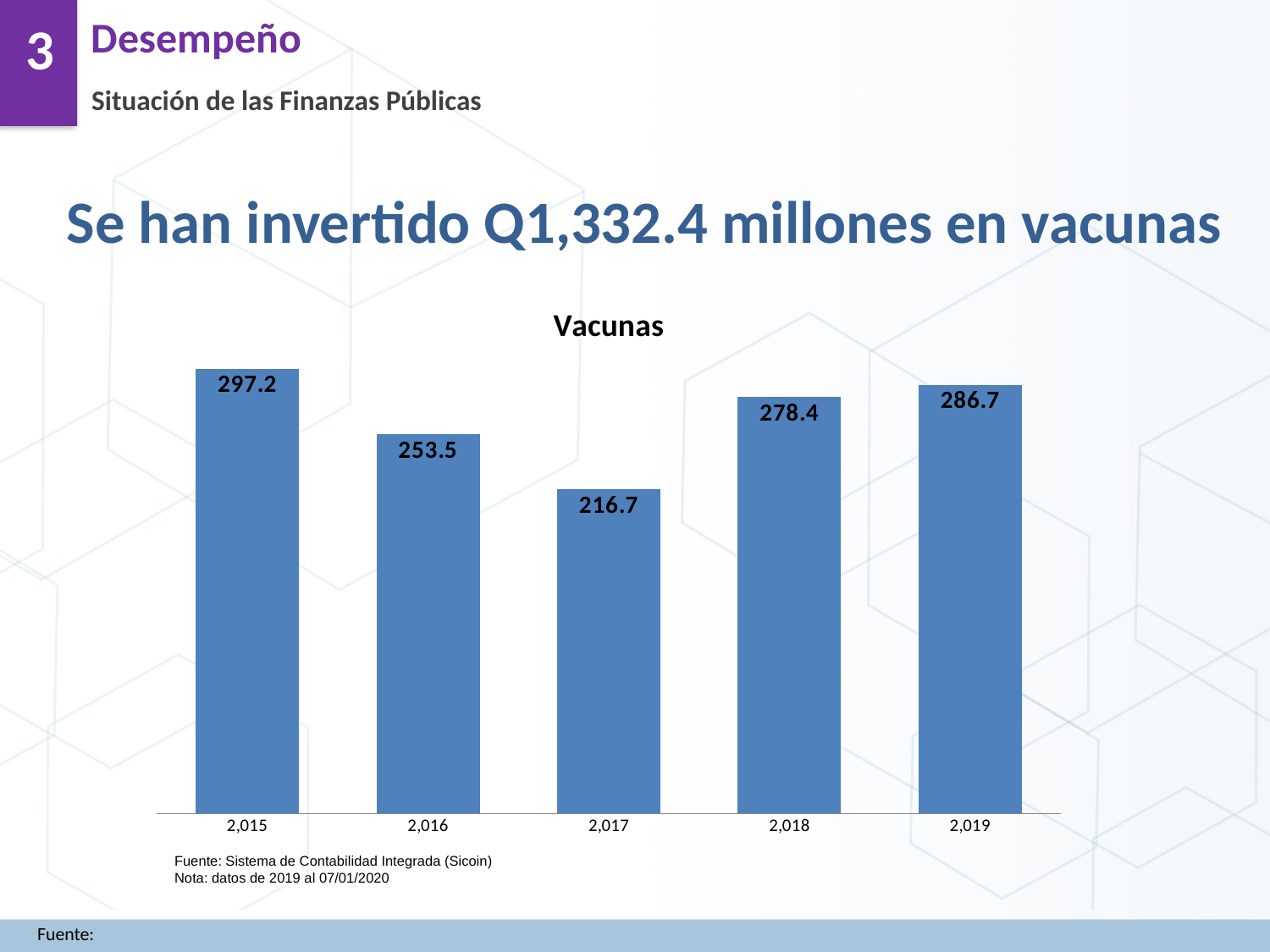
What is the difference between the values for 2,015 and 2,017? 80.5 What is the value for 2,019? 286.7 What is the value for 2,017? 216.7 What is the title of the chart? Vacunas Which is larger, the value for 2,016 or the value for 2,018? 2,018 Do the values rise or fall from 2,015 to 2,017? fall What is the difference between the values for 2,019 and 2,018? 8.3 What is the value for 2,015? 297.2 How many years are shown on the chart? 5 Which year has the lowest value? 2,017 What kind of chart is shown? bar chart Which year has the highest value? 2,015